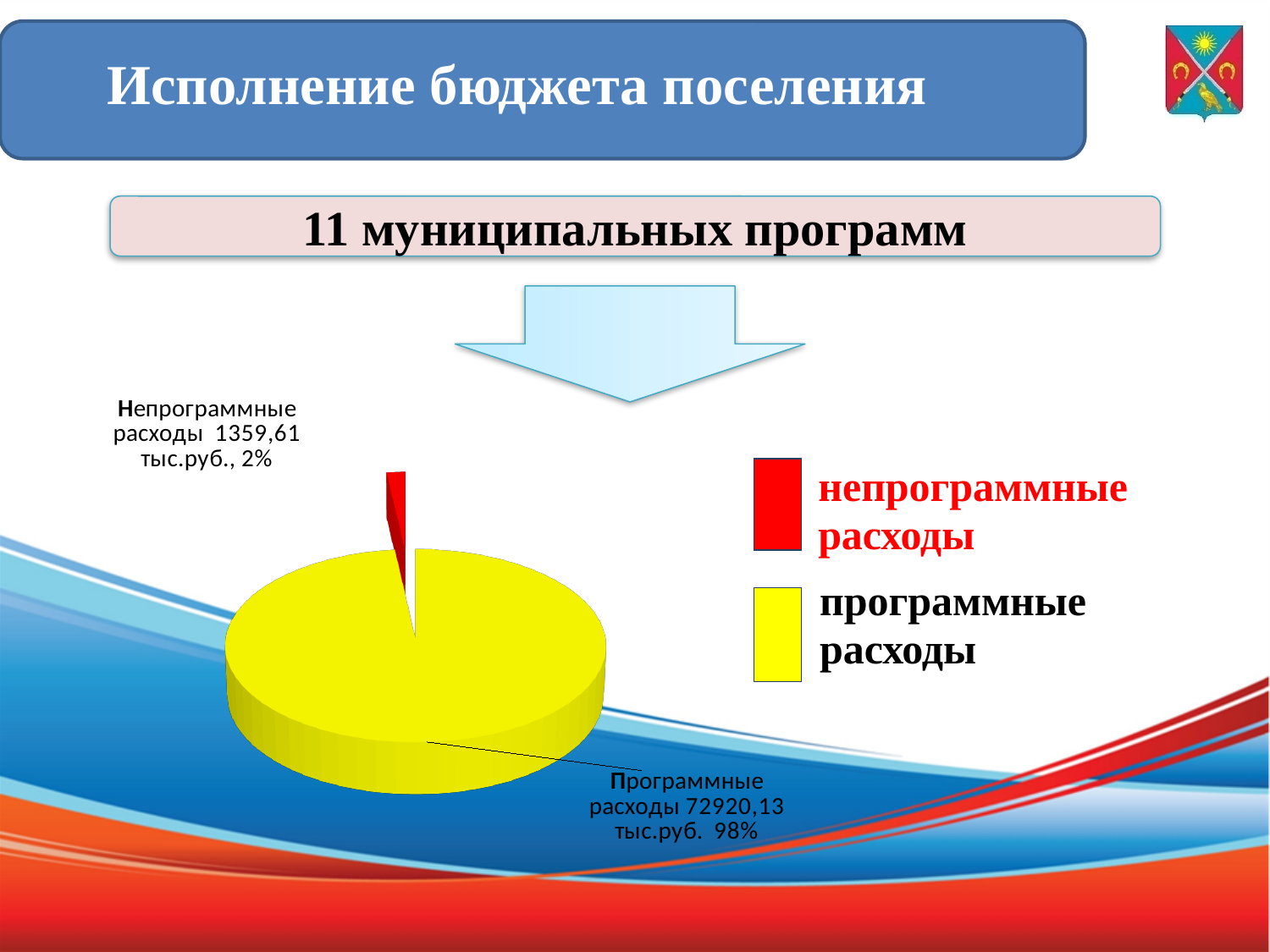
How many slices does the pie chart have? 2 Which is larger, Программные расходы or Непрограммные расходы? Программные расходы What share of the pie do Программные расходы make up? 98% What is the difference between Программные расходы and Непрограммные расходы? 71560,52 тыс.руб. What is the value for Непрограммные расходы? 1359,61 тыс.руб. How many entries does the legend list? 2 What is the value for Программные расходы? 72920,13 тыс.руб. What kind of chart is shown on the slide? pie chart Which slice is the smallest? Непрограммные расходы What colour represents непрограммные расходы in the legend? red Which slice is the largest? Программные расходы What share of the pie do Непрограммные расходы make up? 2%